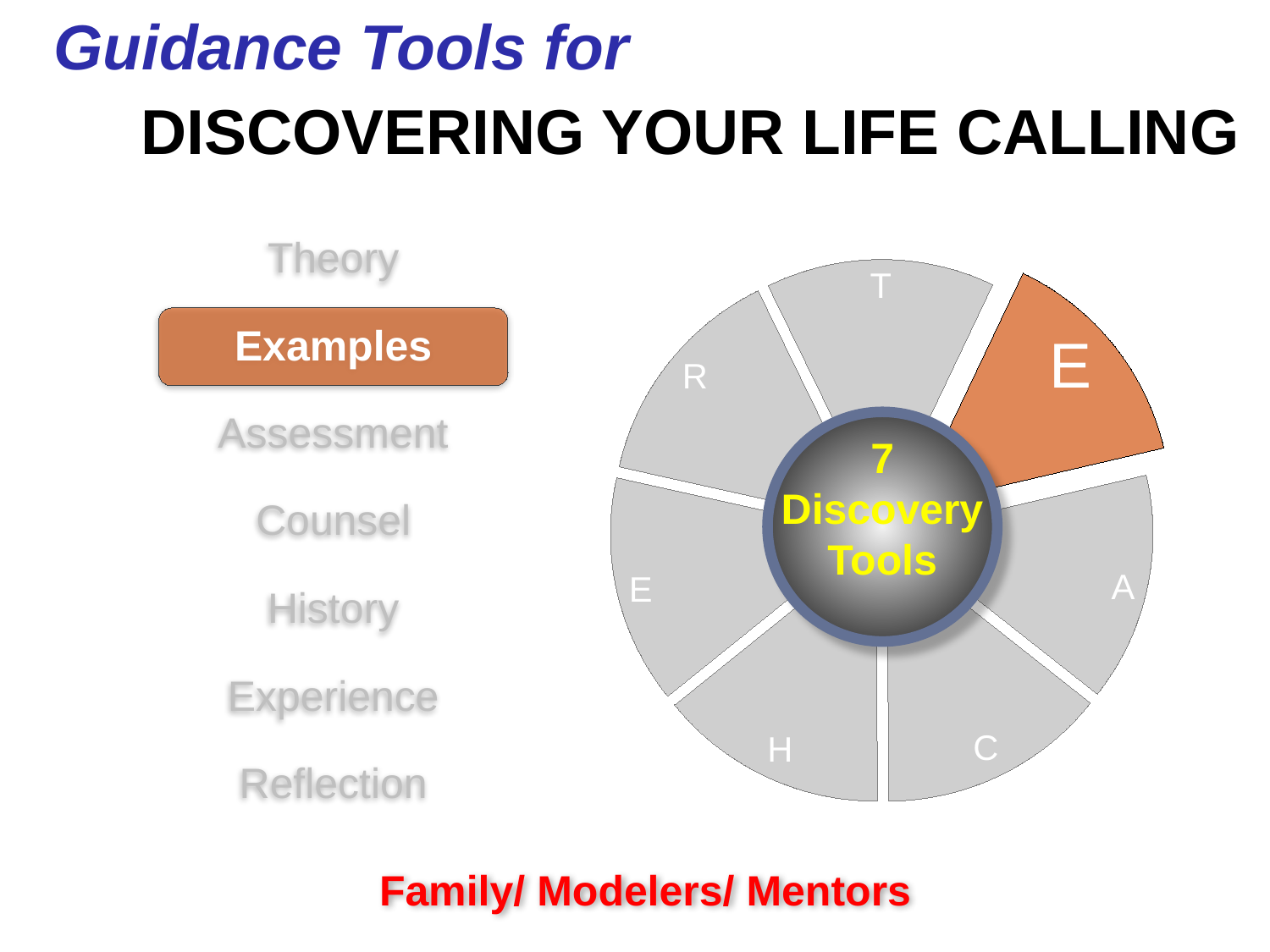
Which item in the left-hand list is highlighted with an orange box? Examples What letter is shown in the segment at the right of the wheel diagram, below the orange segment? A How many items are in the list on the left side of the slide (Theory through Reflection)? 7 What letter is shown in the top segment of the wheel diagram? T What text is written in the centre circle of the wheel diagram? 7 Discovery Tools How many segments does the circular diagram around "7 Discovery Tools" have? 7 Which segment of the wheel diagram is highlighted in orange? E